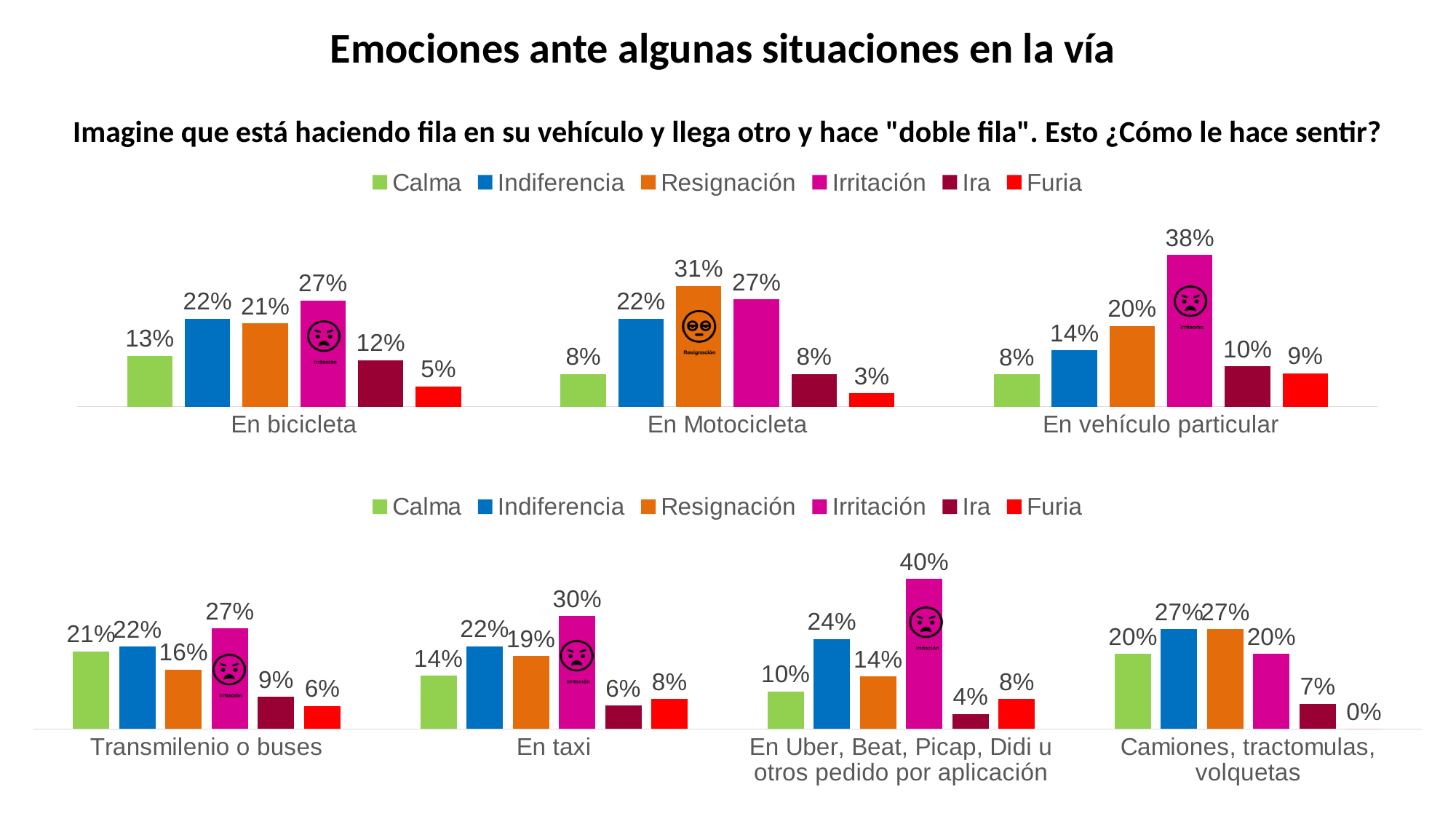
Which colour represents Furia in the legend? Red In the bottom chart, what is the value for Furia for Camiones, tractomulas, volquetas? 0% In the top chart, which emotion has the lowest value for En Motocicleta? Furia What kind of chart is the top chart? Bar chart How many vehicle categories are shown on the x axis of the bottom chart? 4 How many series does the legend of the bottom chart list? 6 In the bottom chart, which is larger for En taxi: Indiferencia or Resignación? Indiferencia In the top chart, what is the difference between Irritación and Calma for En bicicleta? 14% In the top chart, what is the value for Resignación for En Motocicleta? 31% In the bottom chart, what is the difference between Irritación and Ira for Transmilenio o buses? 18% In the bottom chart, which emotion has the highest value for En Uber, Beat, Picap, Didi u otros pedido por aplicación? Irritación In the top chart, what is the value for Irritación for En vehículo particular? 38%